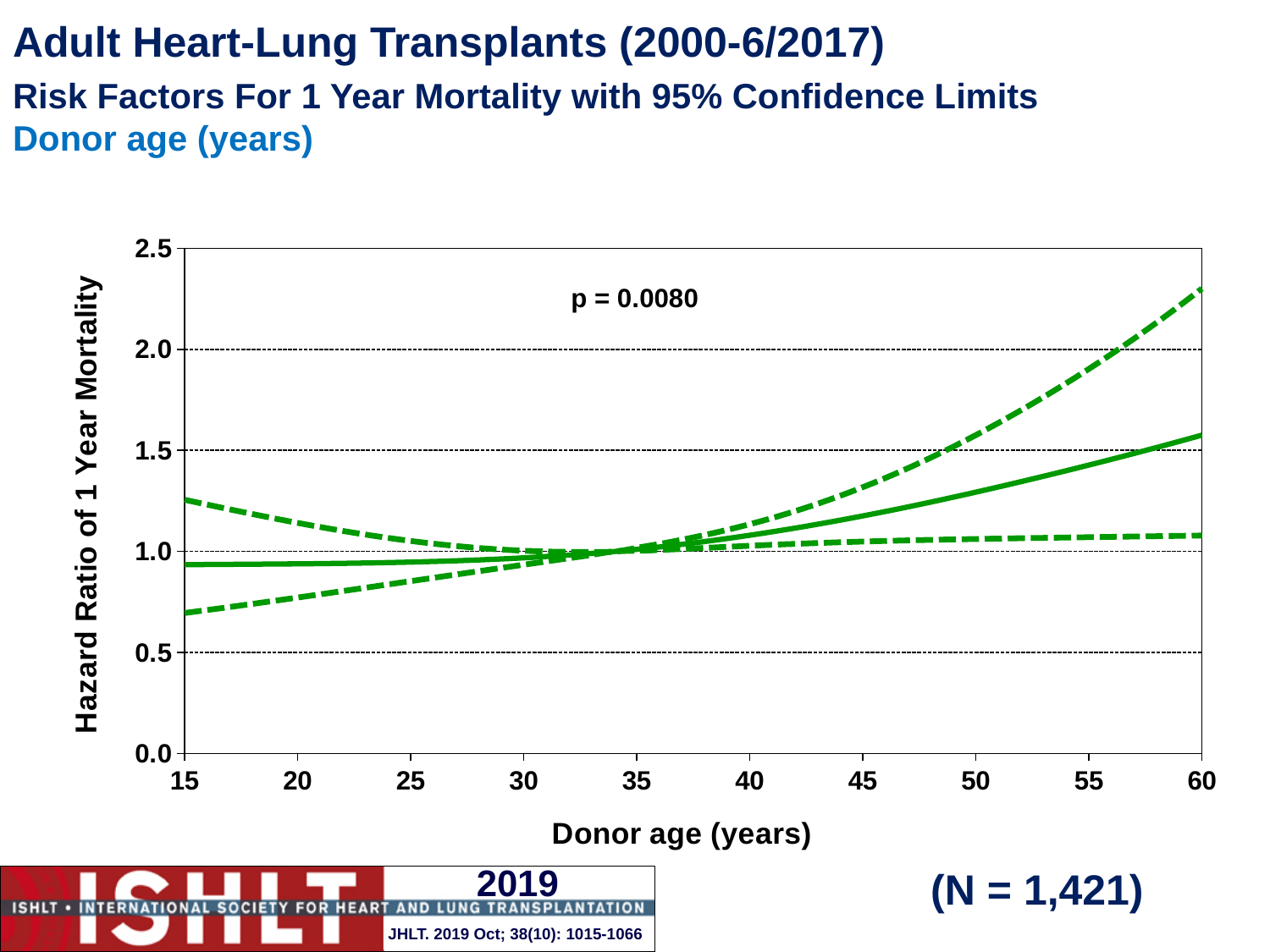
Is the upper 95% confidence limit (upper dashed line) at donor age 15 greater or less than 1.5? less At which donor age shown on the x axis is the hazard ratio (solid line) highest? 60 What is the sample size (N) shown on the slide? N = 1,421 Is the hazard ratio (solid line) at donor age 60 greater or less than 1.0? greater What kind of chart is shown on the slide? line chart Is the hazard ratio (solid line) at donor age 60 greater or less than 2.0? less What p-value is printed on the chart? p = 0.0080 Which has the larger hazard ratio on the solid line: donor age 15 or donor age 60? donor age 60 Does the solid hazard ratio line rise or fall as donor age increases from 15 to 60 years? rise